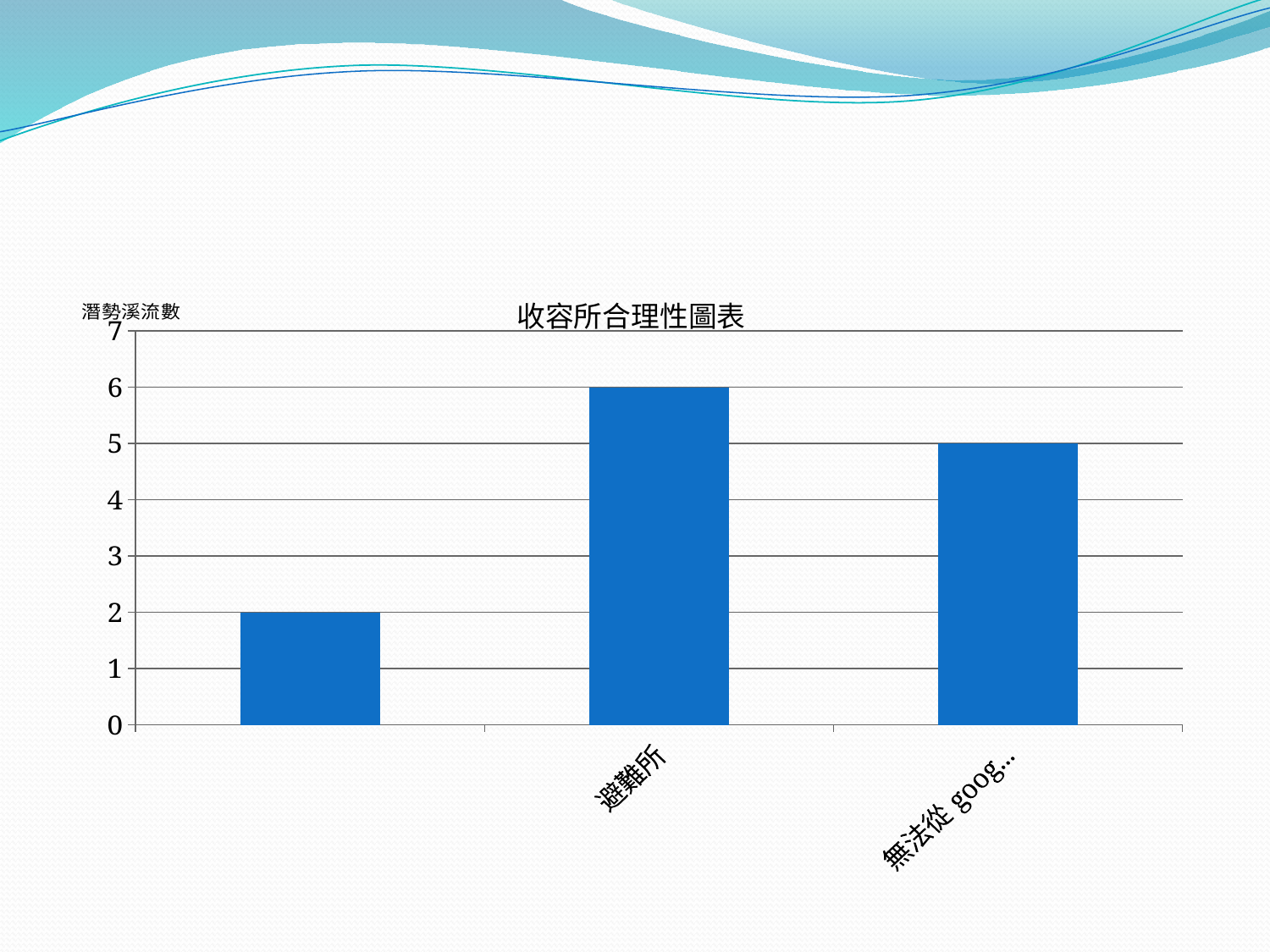
Is the value for 無法從 goog… greater or less than 4? greater Which category has the highest value? 避難所 What is the title of the chart? 收容所合理性圖表 How many bars are plotted in the chart? 3 What kind of chart is shown on the slide? bar chart What is the value for 避難所? 6 What is the difference between the values for 避難所 and 無法從 goog…? 1 Is the value for 避難所 greater or less than 5? greater Which is larger, the value for 避難所 or the value for 無法從 goog…? 避難所 What is the value for the category labelled 無法從 goog…? 5 What is the label on the vertical axis of the chart? 潛勢溪流數 What is the value of the leftmost bar in the chart? 2